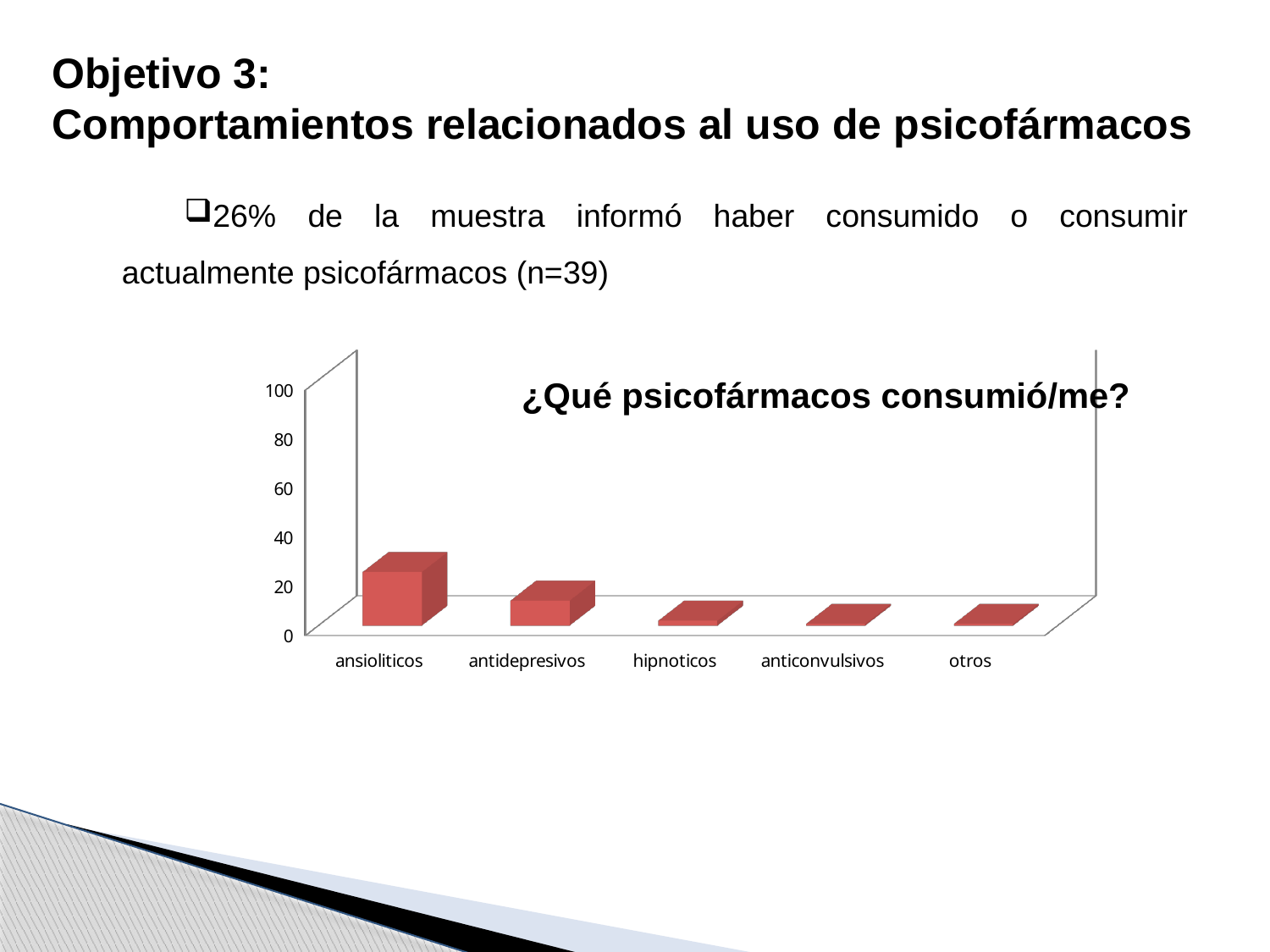
Which is larger, the value for ansioliticos or the value for antidepresivos? ansioliticos Which is larger, the value for antidepresivos or the value for hipnoticos? antidepresivos Is the value for ansioliticos greater or less than 40? less Is the value for hipnoticos greater or less than 20? less Which category has the highest value in the chart? ansioliticos What kind of chart is shown on the slide? bar chart What is the highest value shown on the vertical axis of the chart? 100 How many categories are shown on the x axis of the chart? 5 What is the title of the chart? ¿Qué psicofármacos consumió/me? Is the value for antidepresivos greater or less than 20? less Do the bar values rise or fall moving from left to right along the x axis? fall